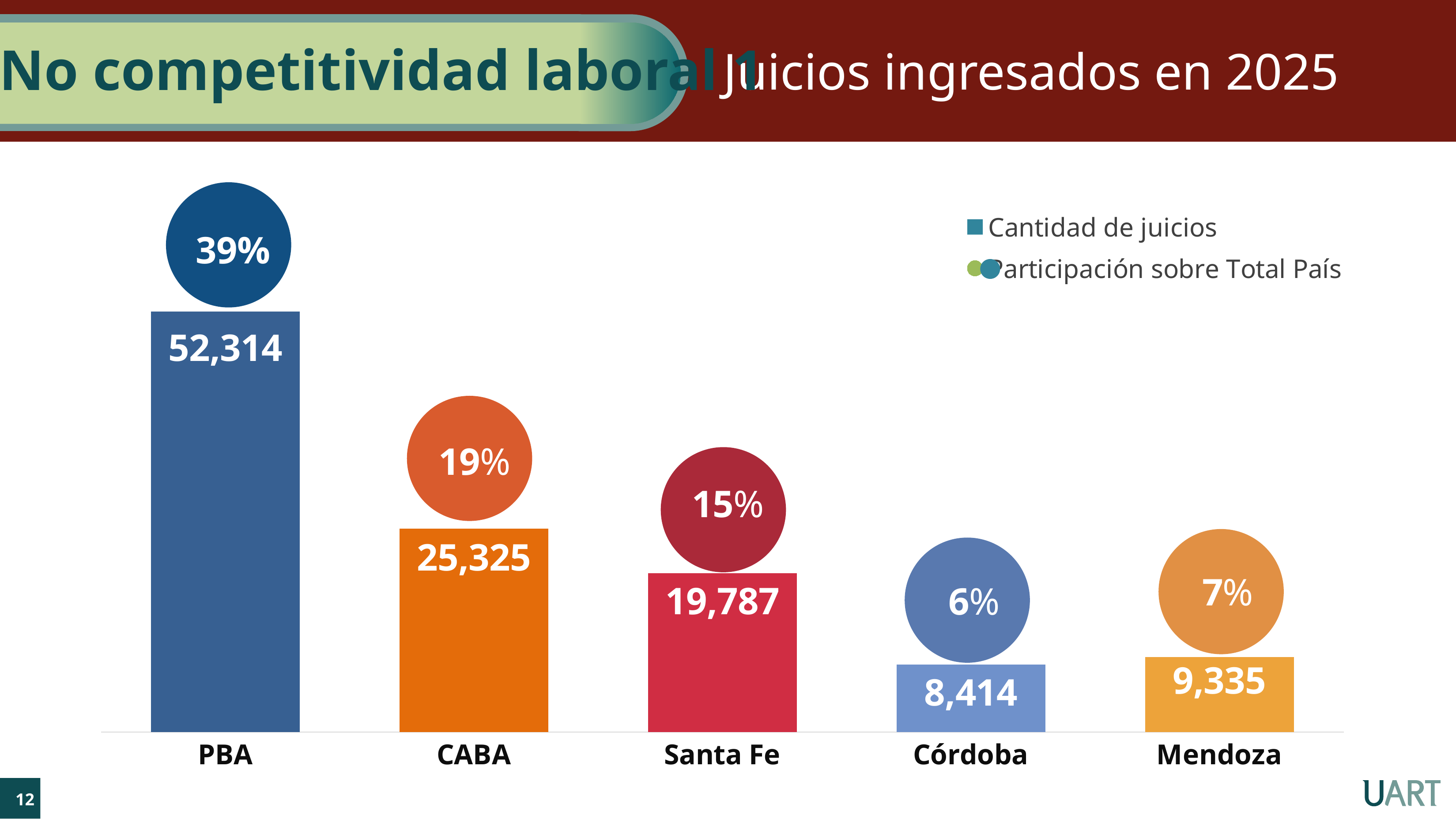
What is the number of juicios for Santa Fe? 19,787 What is the Participación sobre Total País for Mendoza? 7% What is the Participación sobre Total País for CABA? 19% What is the difference in number of juicios between PBA and CABA? 26,989 Which province has the lowest number of juicios? Córdoba What is the number of juicios (Cantidad de juicios) for PBA? 52,314 What is the difference in Participación sobre Total País between PBA and Santa Fe? 24% Which province has the highest number of juicios? PBA How many provinces are shown on the x axis? 5 What kind of chart is shown on the slide? Bar chart How many series does the legend list? 2 Which has more juicios, Mendoza or Córdoba? Mendoza